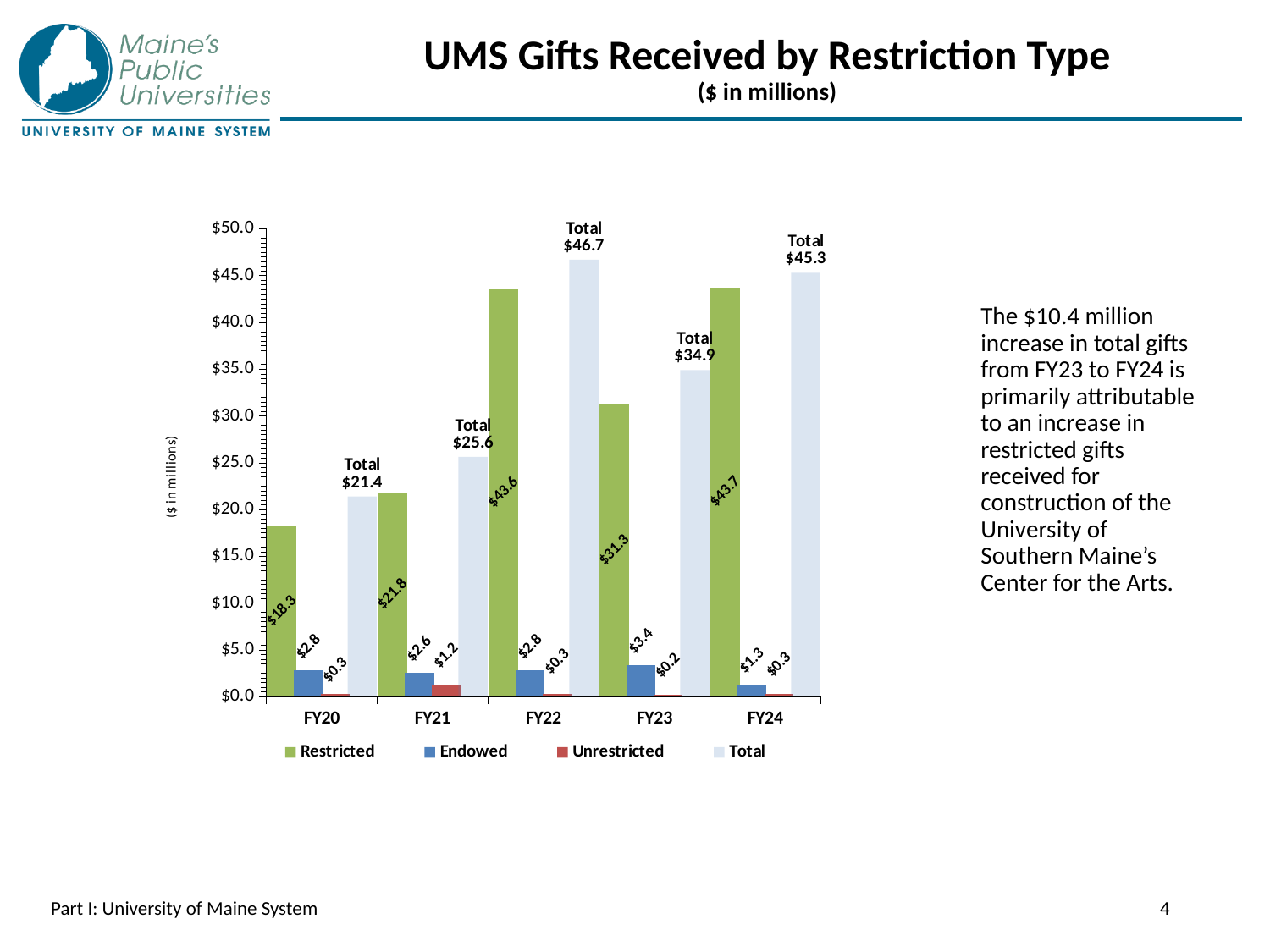
What was the Restricted gifts value for FY23? $31.3 What was the Endowed gifts value for FY24? $1.3 What is the difference between the total gifts in FY24 and FY23? $10.4 What was the Unrestricted gifts value for FY21? $1.2 What kind of chart is shown on the slide? Bar chart What was the total gifts value for FY22? $46.7 How many series does the legend list? 4 Which fiscal year had the highest Endowed gifts value? FY23 How many fiscal years are shown on the x axis? 5 Which is larger, the Restricted gifts value in FY21 or in FY23? FY23 Which fiscal year had the highest total gifts? FY22 Which fiscal year had the lowest total gifts? FY20